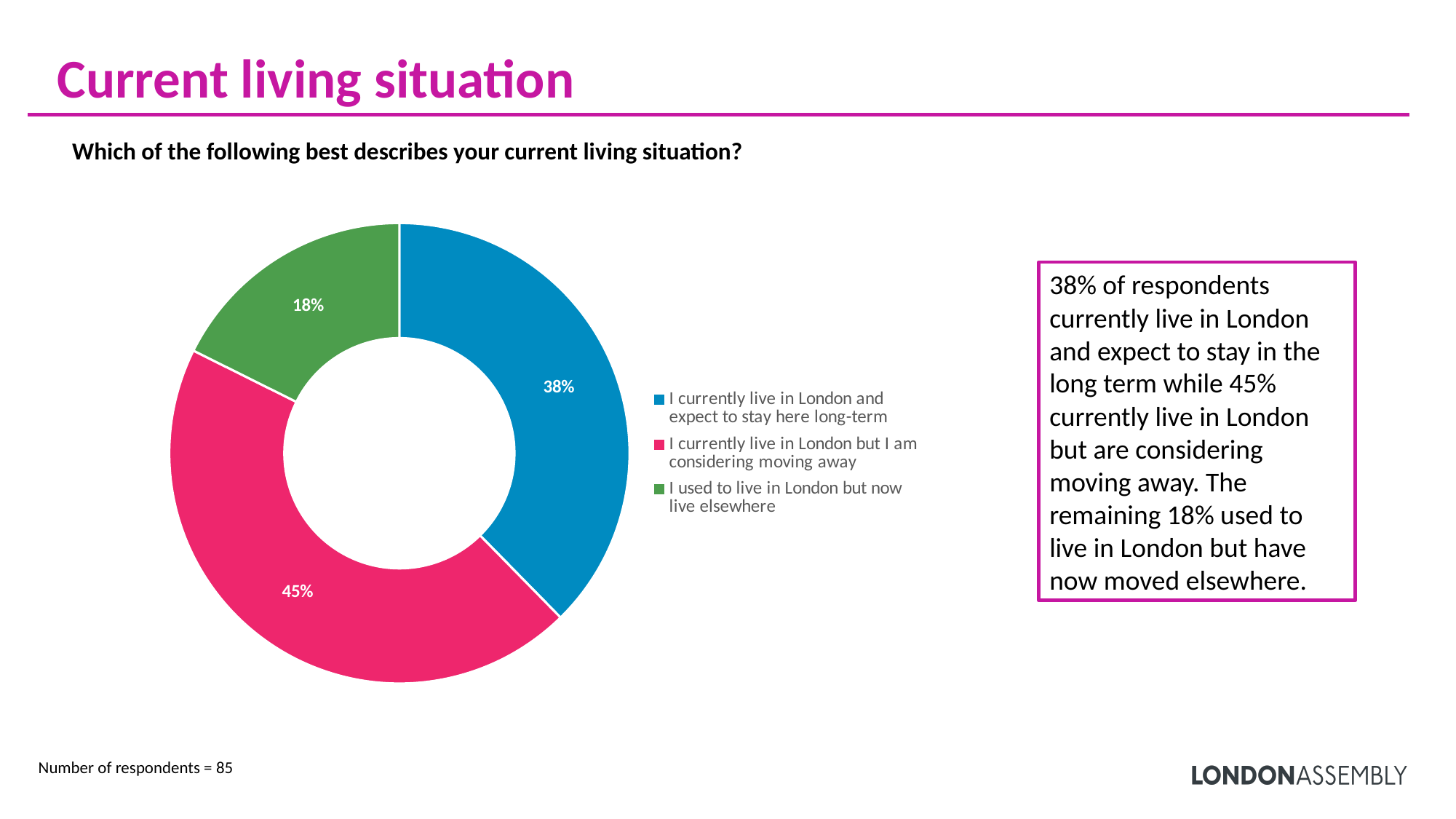
What colour represents the category 'I used to live in London but now live elsewhere'? Green What is the difference in percentage points between those considering moving away and those expecting to stay long-term? 7 Which living situation category has the largest share of respondents? I currently live in London but I am considering moving away What is the difference in percentage points between those expecting to stay long-term and those who now live elsewhere? 20 How many respondents answered the question, according to the slide? 85 What kind of chart is shown on the slide? Doughnut (pie) chart How many categories are shown in the chart? 3 What percentage of respondents used to live in London but now live elsewhere? 18% Which living situation category has the smallest share of respondents? I used to live in London but now live elsewhere What percentage of respondents currently live in London and expect to stay here long-term? 38% What percentage of respondents currently live in London but are considering moving away? 45% Which is larger: the share who expect to stay in London long-term or the share who used to live in London but now live elsewhere? I currently live in London and expect to stay here long-term